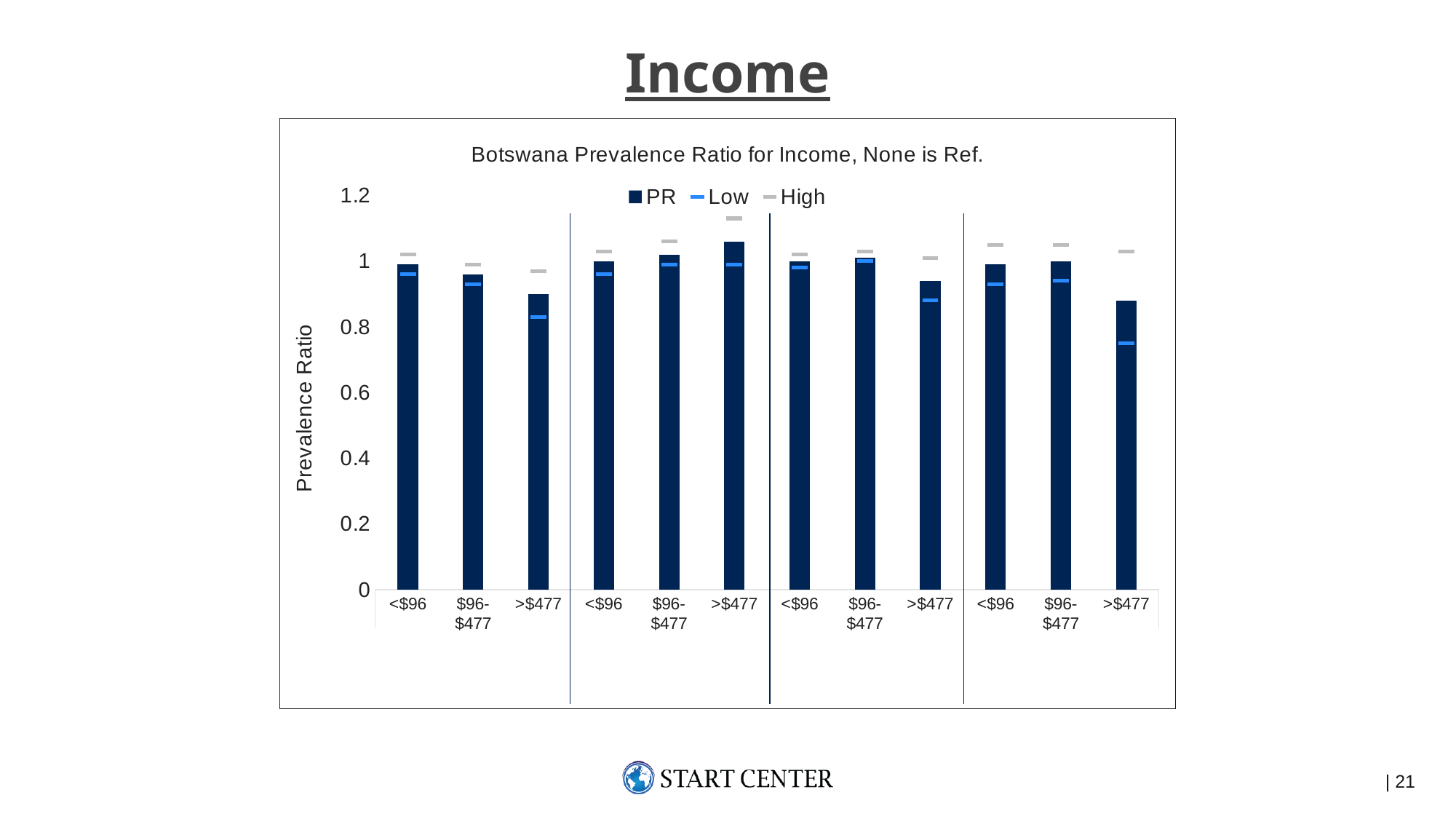
How many PR bars are plotted in the chart? 12 Is the PR value for >$477 in the fourth group greater or less than 1? less How many series does the chart legend list? 3 What is the label of the vertical axis? Prevalence Ratio Is the Low marker for >$477 in the fourth group greater or less than 0.8? less What kind of chart is shown on the slide? Bar chart Which PR bar is the highest in the chart? >$477 in the second group Which PR bar is larger: >$477 in the first group or >$477 in the second group? >$477 in the second group Within the first group of bars, do the PR values rise or fall from <$96 to >$477? fall What is the title of the chart? Botswana Prevalence Ratio for Income, None is Ref. Is the PR value for >$477 in the second group greater or less than 1? greater Which PR bar is the lowest in the chart? >$477 in the fourth group